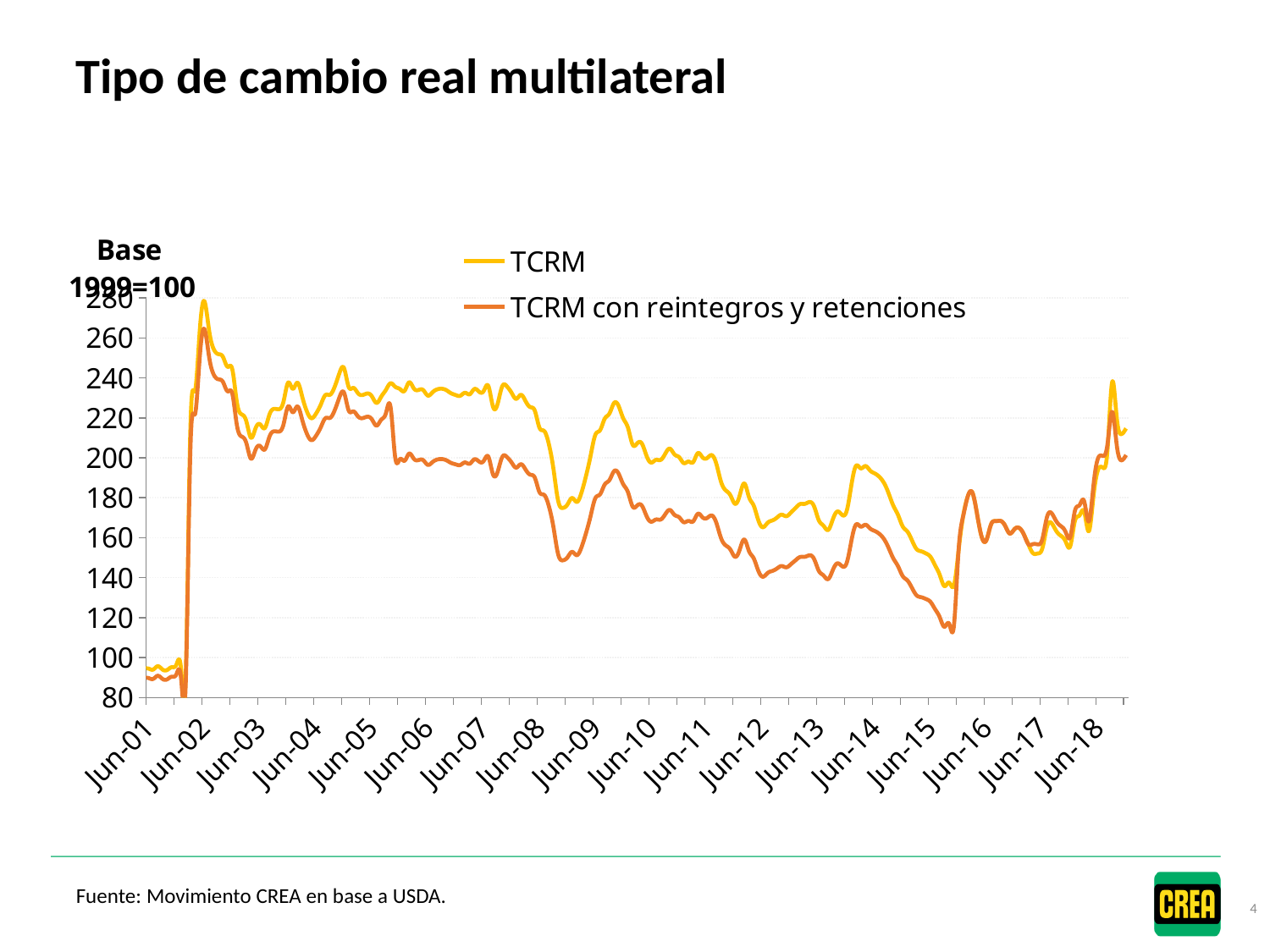
Which series is higher at Jun-10, TCRM or TCRM con reintegros y retenciones? TCRM Is the value of TCRM around Jun-06 greater or less than 220? greater Which series reaches the highest peak on the chart? TCRM What are the two series named in the legend? TCRM; TCRM con reintegros y retenciones How many labelled dates are shown on the x axis? 18 Is the value of TCRM con reintegros y retenciones just before Jun-16 greater or less than 120? less What kind of chart is shown on the slide? line chart Is the value of TCRM at Jun-01 greater or less than 100? less What base is stated for the index on the chart? Base 1999=100 Between Jun-10 and Jun-15, does the TCRM series generally rise or fall? fall How many series does the legend list? 2